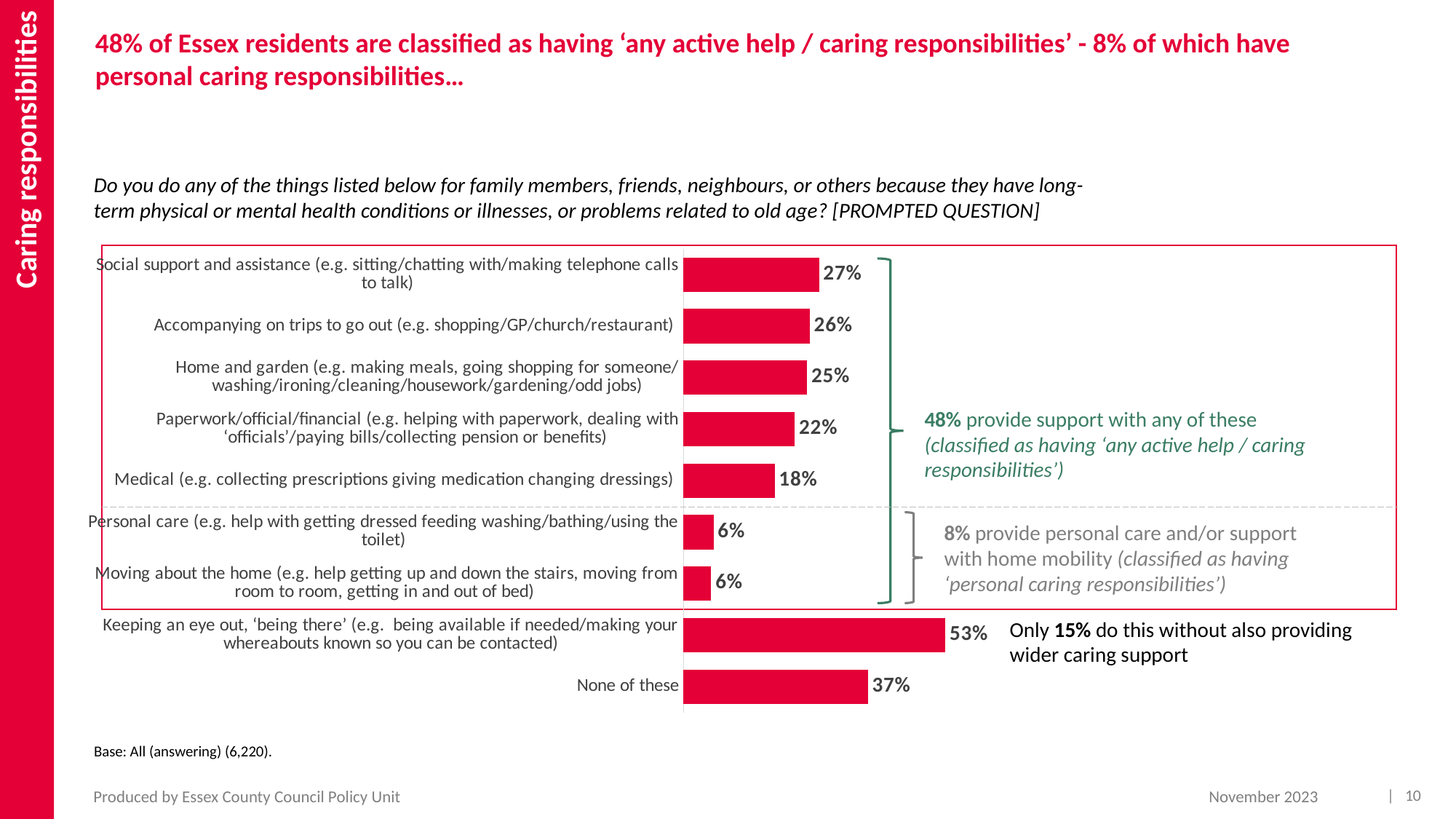
Which is larger: 'Accompanying on trips to go out' or 'Paperwork/official/financial'? Accompanying on trips to go out What type of chart is shown on the slide? Bar chart What is the difference between 'Keeping an eye out, being there' and 'None of these'? 16% What percentage of respondents provide social support and assistance? 27% What percentage of respondents selected 'None of these'? 37% According to the annotation, what percentage provide support with any of the first five activities? 48% What is the value for 'Medical (e.g. collecting prescriptions giving medication changing dressings)'? 18% What is the value for 'Home and garden'? 25% What is the value for 'Personal care'? 6% How many categories are shown in the bar chart? 9 What is the difference between 'Social support and assistance' and 'Medical'? 9% Which category has the highest value in the chart? Keeping an eye out, 'being there'